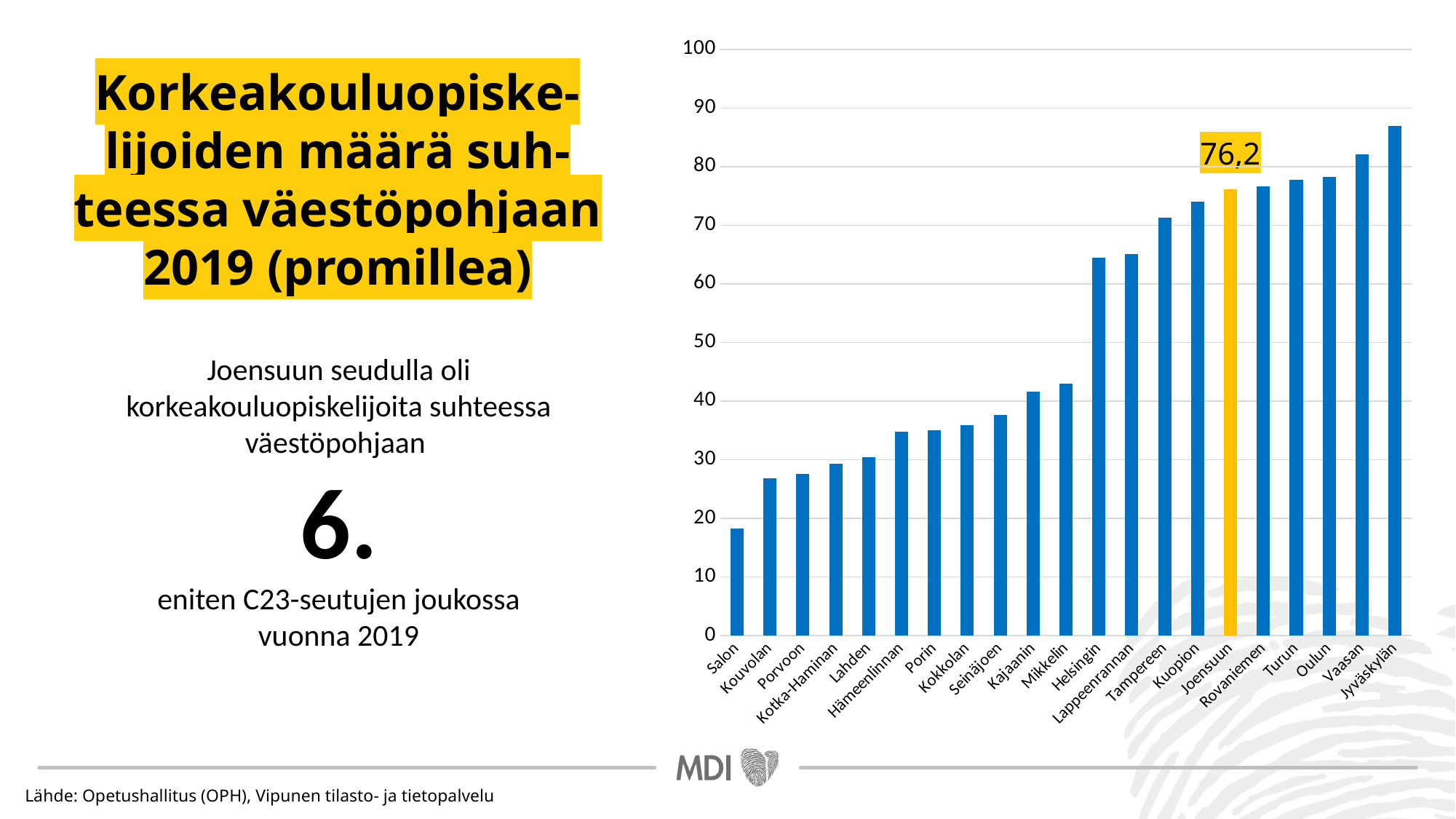
Is the value for Jyväskylän greater or less than 80? greater Do the values rise or fall from left to right along the x axis? rise Which region has the lowest value? Salon Is the value for Helsingin greater or less than 60? greater Which region has the highest value? Jyväskylän Which is larger, the value for Vaasan or the value for Rovaniemen? Vaasan How many regions are shown on the x axis? 21 Which region's bar is highlighted in yellow? Joensuun What is the value for Joensuun? 76,2 Is the value for Salon greater or less than 20? less What kind of chart is shown on the slide? bar chart